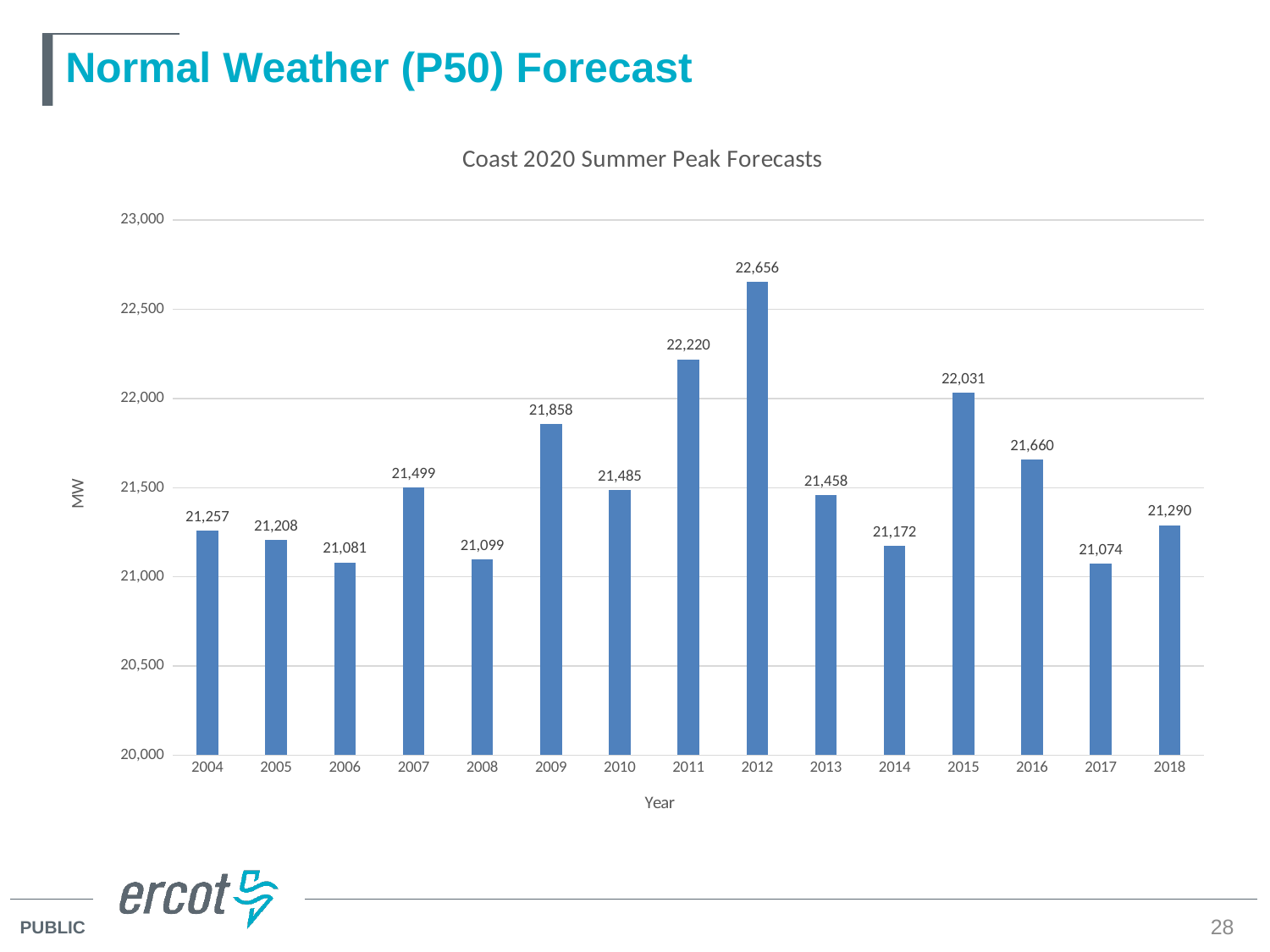
Which year has the lowest forecast value? 2017 What kind of chart is shown on the slide? bar chart Which is larger, the value for 2015 or the value for 2016? 2015 Is the value for 2013 greater or less than 21,500? less What is the forecast value for 2012? 22,656 What is the difference between the 2012 and 2011 forecast values? 436 What is the title of the chart? Coast 2020 Summer Peak Forecasts How many years are shown on the x axis? 15 Which year has the highest forecast value? 2012 Do the values rise or fall from 2016 to 2017? fall What is the forecast value for 2017? 21,074 What is the forecast value for 2009? 21,858